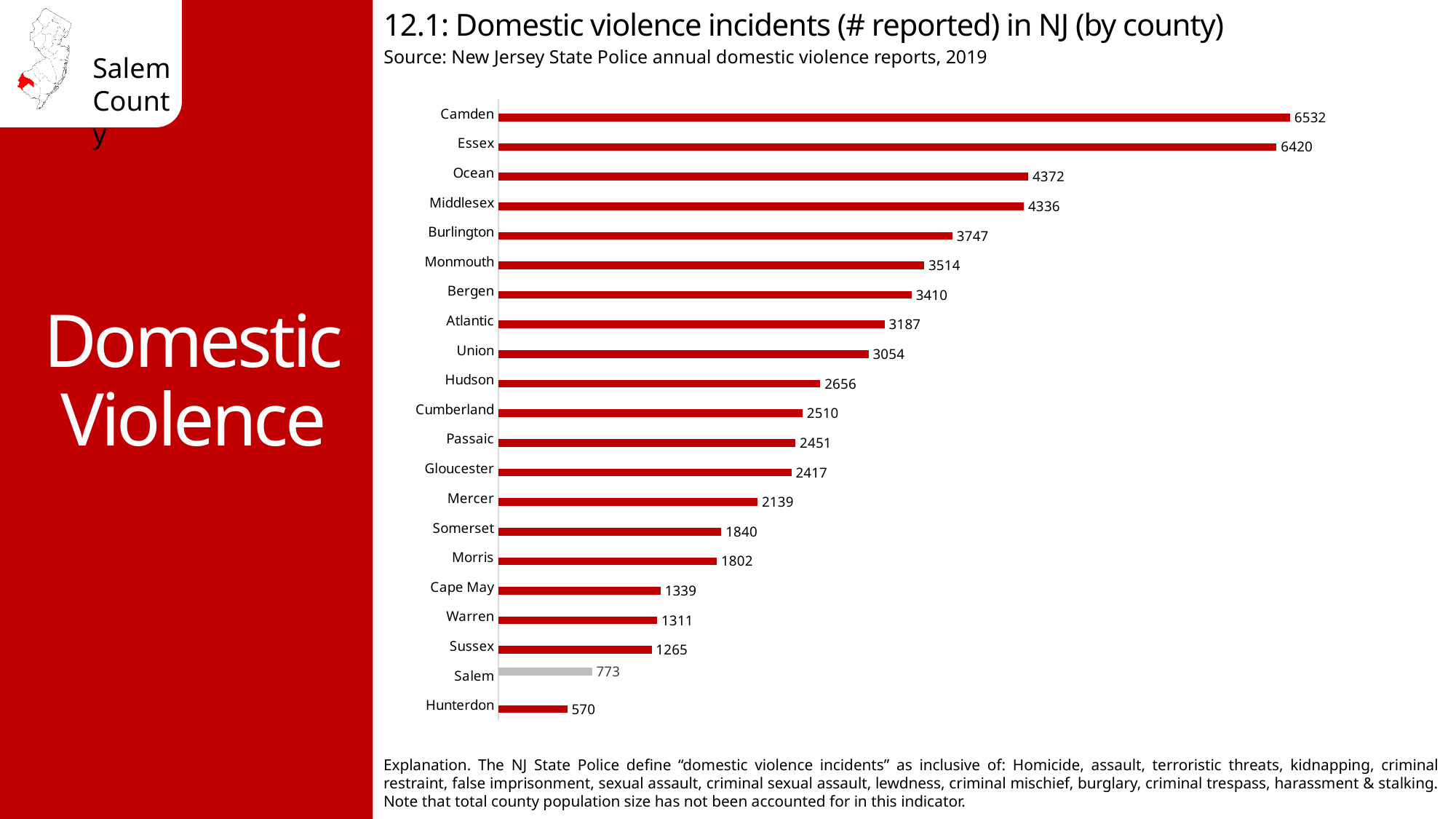
Which county's bar is shown in grey rather than red? Salem What is the number of reported domestic violence incidents for Salem County? 773 What is the number of reported domestic violence incidents for Camden County? 6532 How many counties are shown in the chart? 21 Which county has more reported domestic violence incidents, Salem or Sussex? Sussex What is the number of reported domestic violence incidents for Gloucester County? 2417 What type of chart is used to show domestic violence incidents by county? Bar chart Which county has more reported domestic violence incidents, Cumberland or Passaic? Cumberland Which county has the highest number of reported domestic violence incidents? Camden What is the difference in reported domestic violence incidents between Camden and Essex? 112 What is the difference in reported domestic violence incidents between Salem and Hunterdon? 203 Which county has the lowest number of reported domestic violence incidents? Hunterdon